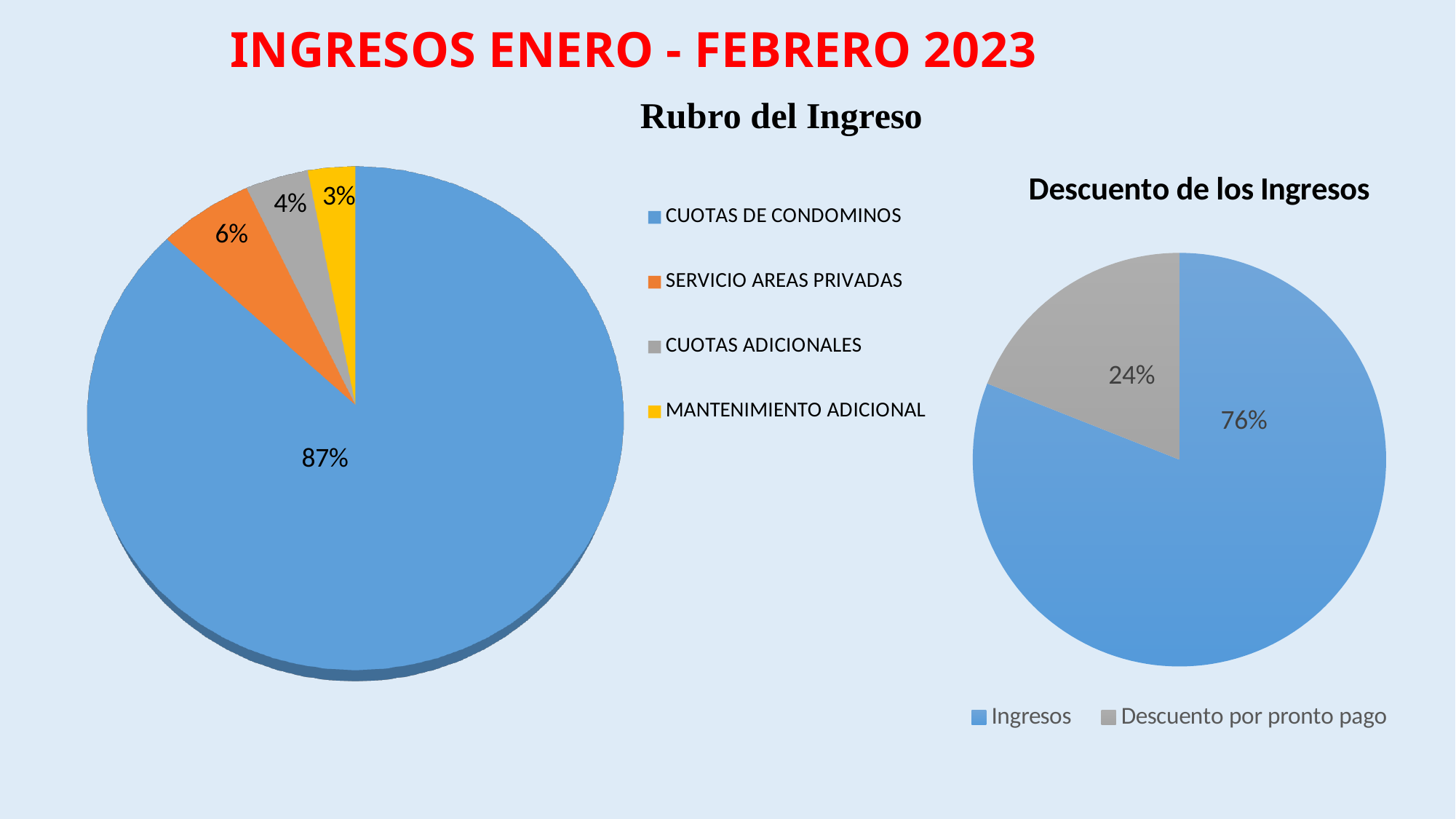
In the 'Rubro del Ingreso' chart, what is the difference between the shares of SERVICIO AREAS PRIVADAS and CUOTAS ADICIONALES? 2% In the 'Rubro del Ingreso' chart, how many categories does the legend list? 4 In the 'Rubro del Ingreso' chart, what share does CUOTAS DE CONDOMINOS have? 87% In the 'Rubro del Ingreso' chart, which category has the largest slice? CUOTAS DE CONDOMINOS In the 'Rubro del Ingreso' chart, what share does SERVICIO AREAS PRIVADAS have? 6% In the 'Descuento de los Ingresos' chart, what share does Ingresos have? 76% What kind of chart is 'Descuento de los Ingresos'? Pie chart In the 'Rubro del Ingreso' chart, which category has the smallest slice? MANTENIMIENTO ADICIONAL In the 'Rubro del Ingreso' chart, what colour is the CUOTAS ADICIONALES slice? Grey In the 'Descuento de los Ingresos' chart, which is larger, Ingresos or Descuento por pronto pago? Ingresos